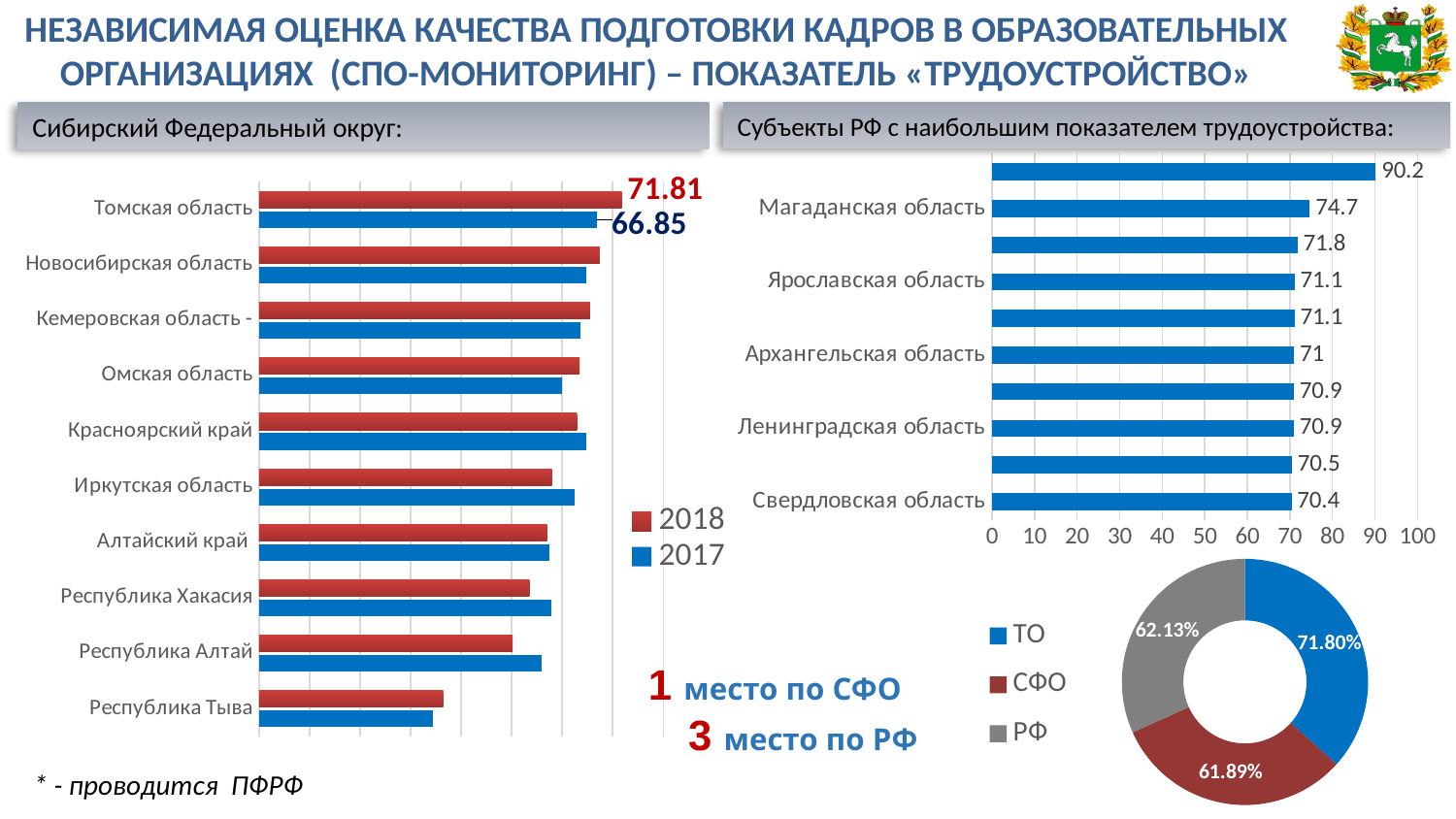
In the left bar chart (Сибирский Федеральный округ), which region has the lowest 2018 value? Республика Тыва What kind of chart is the left chart (Сибирский Федеральный округ)? bar chart In the top-right bar chart (Субъекты РФ с наибольшим показателем трудоустройства), what is the value for Магаданская область? 74.7 In the top-right bar chart (Субъекты РФ с наибольшим показателем трудоустройства), what is the value for Свердловская область? 70.4 In the left bar chart (Сибирский Федеральный округ), how many series does the legend list? 2 In the left bar chart (Сибирский Федеральный округ), which region has the highest 2018 value? Томская область In the left bar chart (Сибирский Федеральный округ), what is the 2017 value for Томская область? 66.85 In the left bar chart (Сибирский Федеральный округ), by how much does the 2018 value for Томская область exceed its 2017 value? 4.96 In the pie chart at the bottom right, what share is shown for ТО? 71.80% In the pie chart at the bottom right, what share is shown for СФО? 61.89% In the left bar chart (Сибирский Федеральный округ), how many regions are shown? 10 In the left bar chart (Сибирский Федеральный округ), what is the 2018 value for Томская область? 71.81